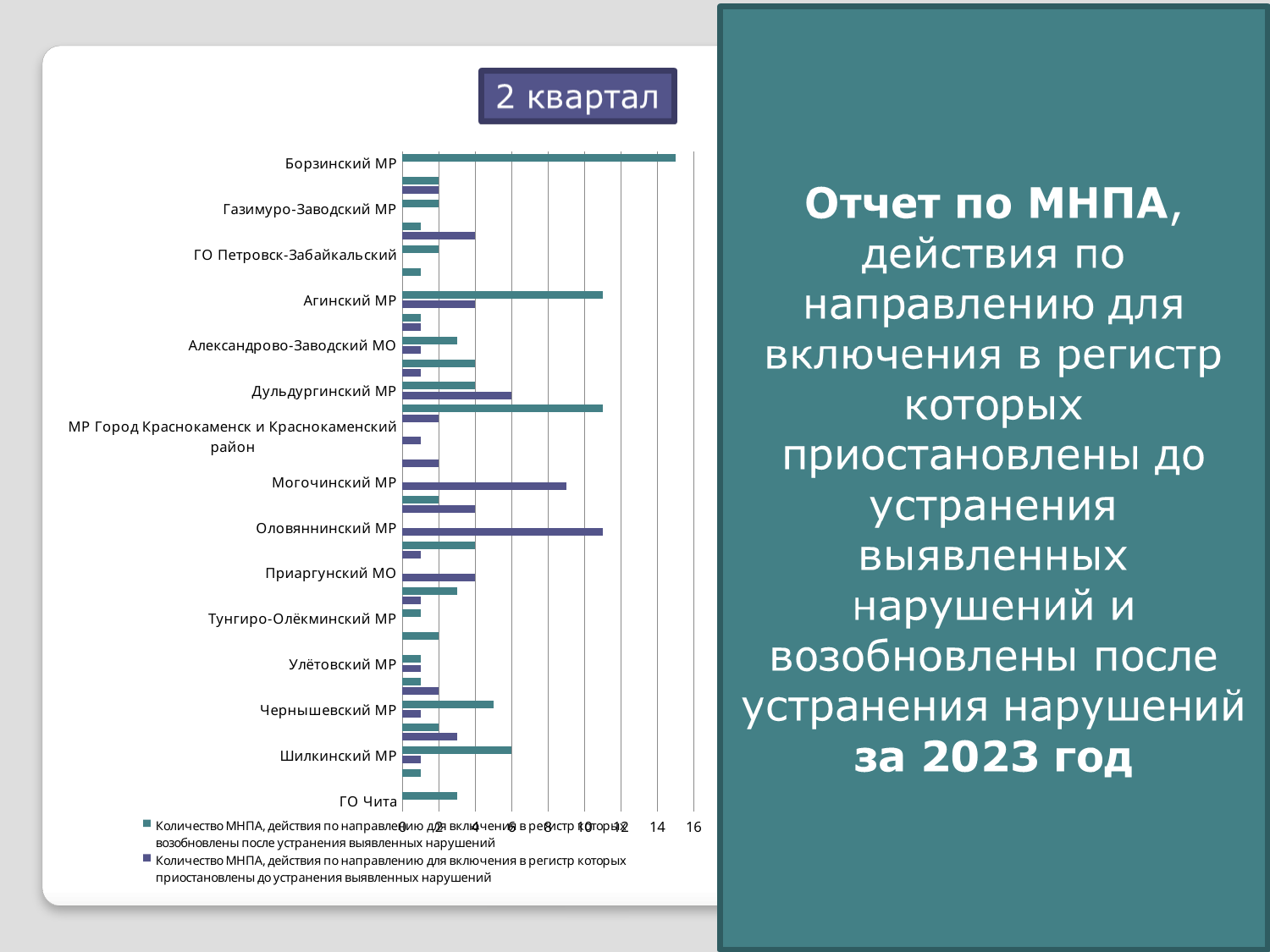
Is the value of the longest bar for Борзинский МР greater or less than 14? greater Is the value of the longest bar for Борзинский МР greater or less than 16? less Which colour represents the series 'Количество МНПА, действия по направлению для включения в регистр которых приостановлены до устранения выявленных нарушений'? purple What kind of chart is shown on the slide? bar chart Which category has the longest bar in the chart? Борзинский МР What is the title shown above the chart? 2 квартал How many series does the chart's legend list? 2